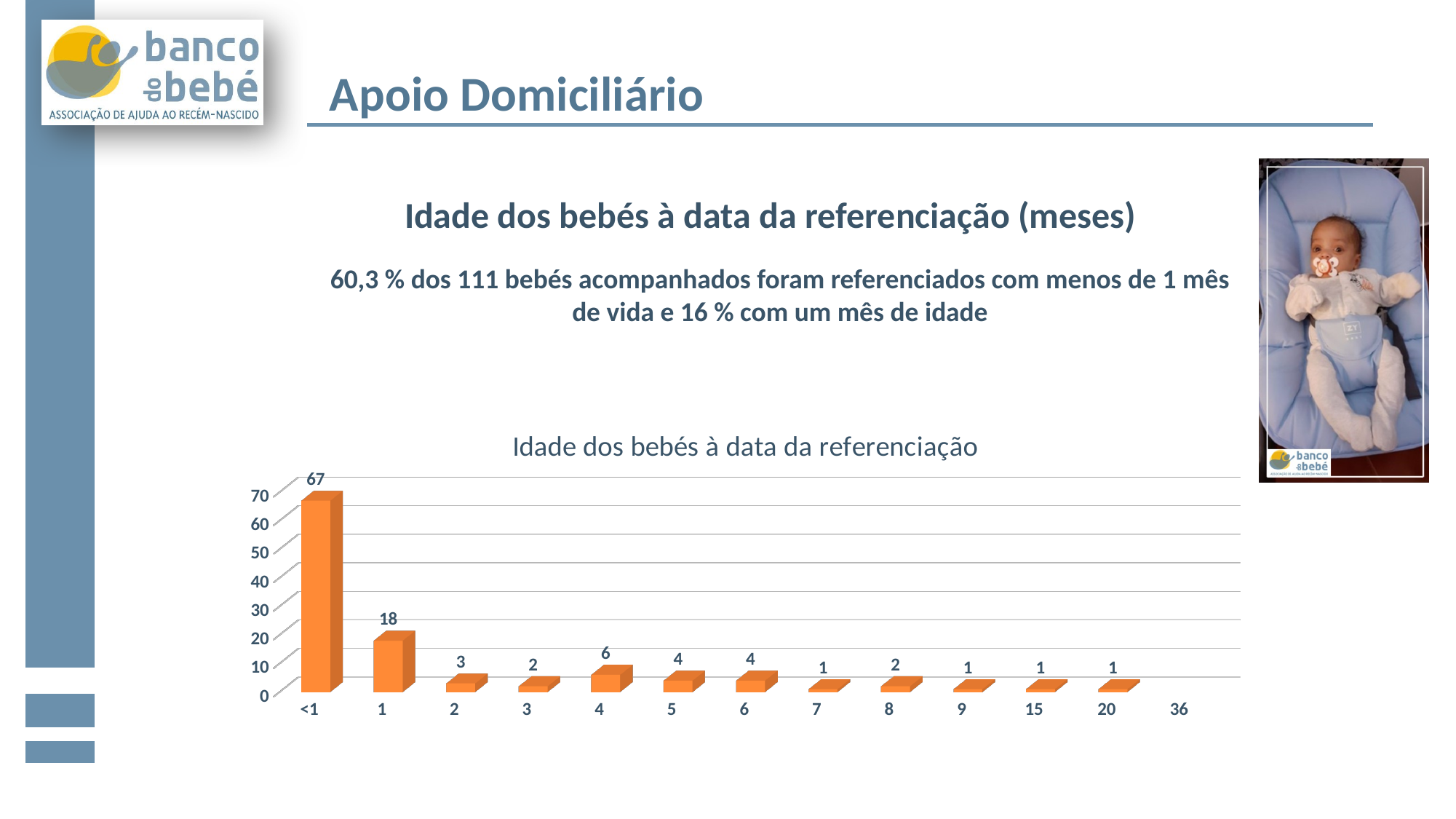
What kind of chart is shown on the slide? bar chart What is the chart's title? Idade dos bebés à data da referenciação What is the value for the category '8'? 2 What is the value for the category '1'? 18 Which is larger, the value for '4' or the value for '5'? 4 What is the value for the category '<1'? 67 What is the value for the category '4'? 6 Which category has the highest value? <1 How many categories are labelled on the x axis? 13 What is the difference between the values for '<1' and '1'? 49 Is the value for '1' greater or less than 20? less What is the difference between the values for '2' and '3'? 1